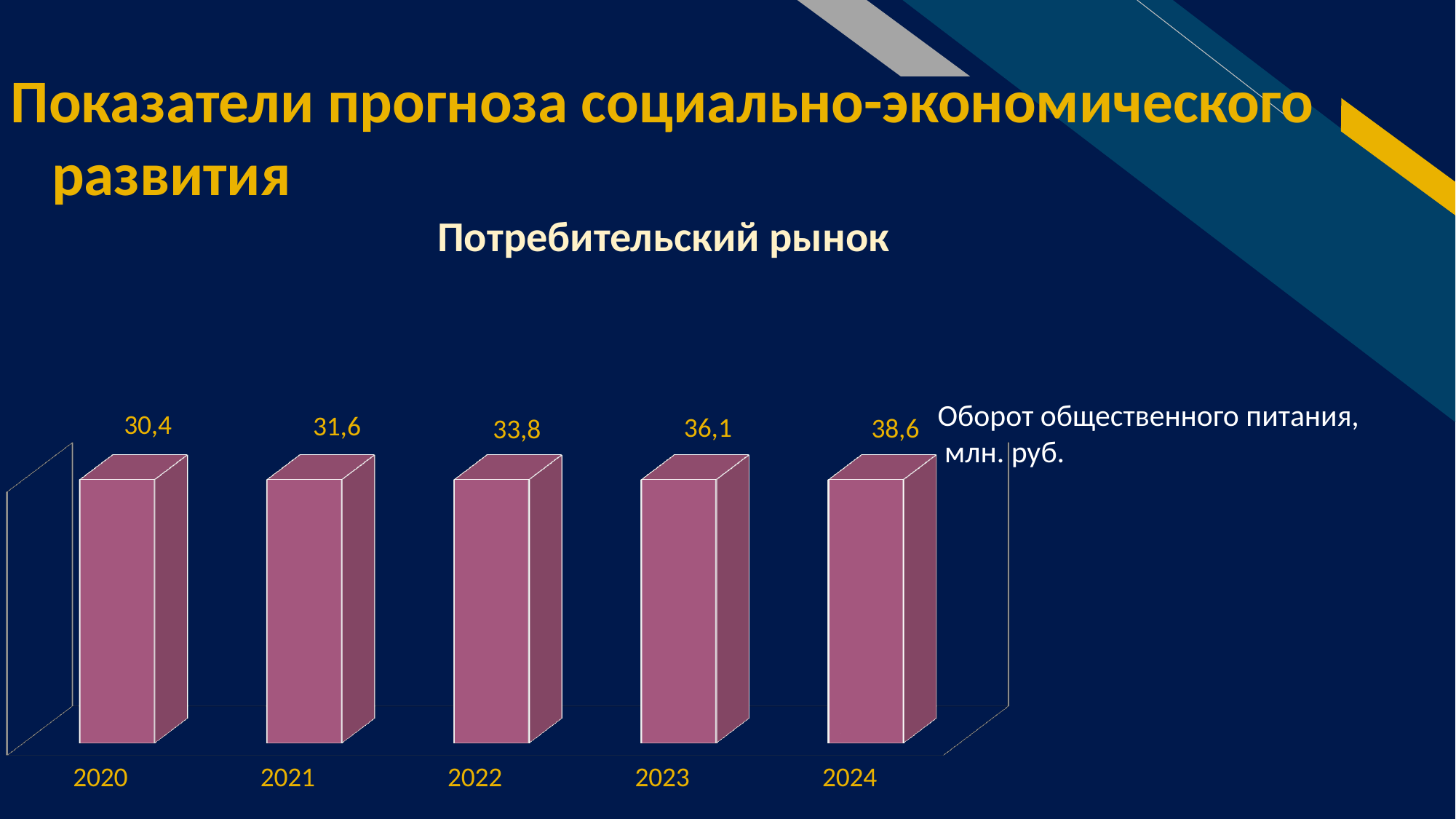
What is the difference between the values for 2024 and 2020? 8,2 What is the difference between the values for 2023 and 2022? 2,3 Which is larger, the value for 2021 or the value for 2023? 2023 What indicator and unit does the chart show, according to the label next to the bars? Оборот общественного питания, млн. руб. Which year has the highest value in the chart? 2024 Which year has the lowest value in the chart? 2020 What is the value for 2022 in the chart? 33,8 What is the value for 2020 in the chart? 30,4 How many years are shown in the chart? 5 Do the values rise or fall from 2020 to 2024? Rise What is the value for 2024 in the chart? 38,6 What kind of chart is shown on the slide? Bar chart